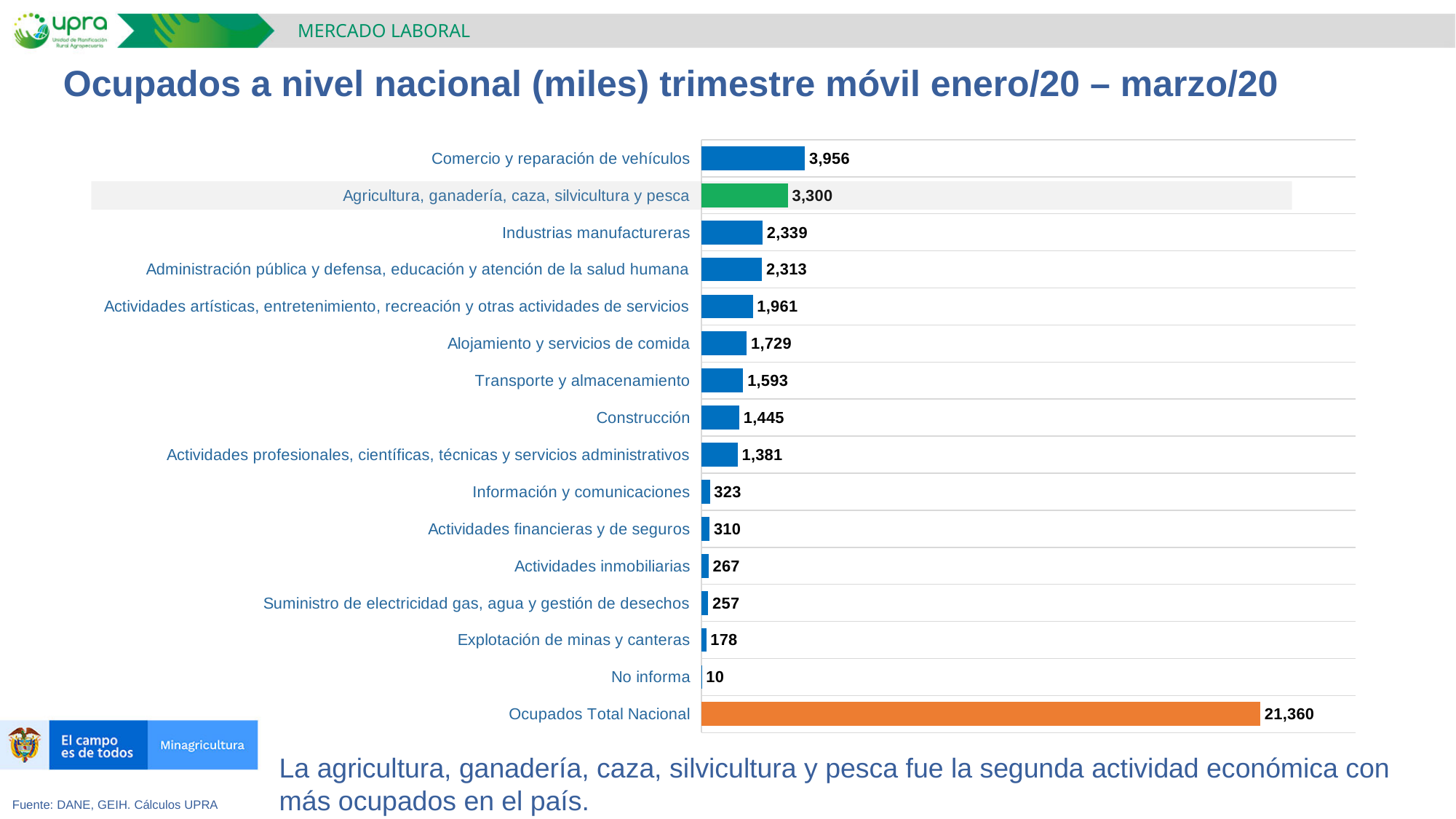
What is the value for Comercio y reparación de vehículos? 3,956 Which category has the lowest value? No informa What colour is the bar for Agricultura, ganadería, caza, silvicultura y pesca? Green What is the difference between Información y comunicaciones and Actividades financieras y de seguros? 13 What is the value for Explotación de minas y canteras? 178 Which is larger, Industrias manufactureras or Construcción? Industrias manufactureras What is the value for Agricultura, ganadería, caza, silvicultura y pesca? 3,300 Excluding the Ocupados Total Nacional bar, which category has the highest value? Comercio y reparación de vehículos How many categories are shown in the chart? 16 What is the difference between Comercio y reparación de vehículos and Agricultura, ganadería, caza, silvicultura y pesca? 656 What kind of chart is shown on the slide? Bar chart What is the value for Ocupados Total Nacional? 21,360